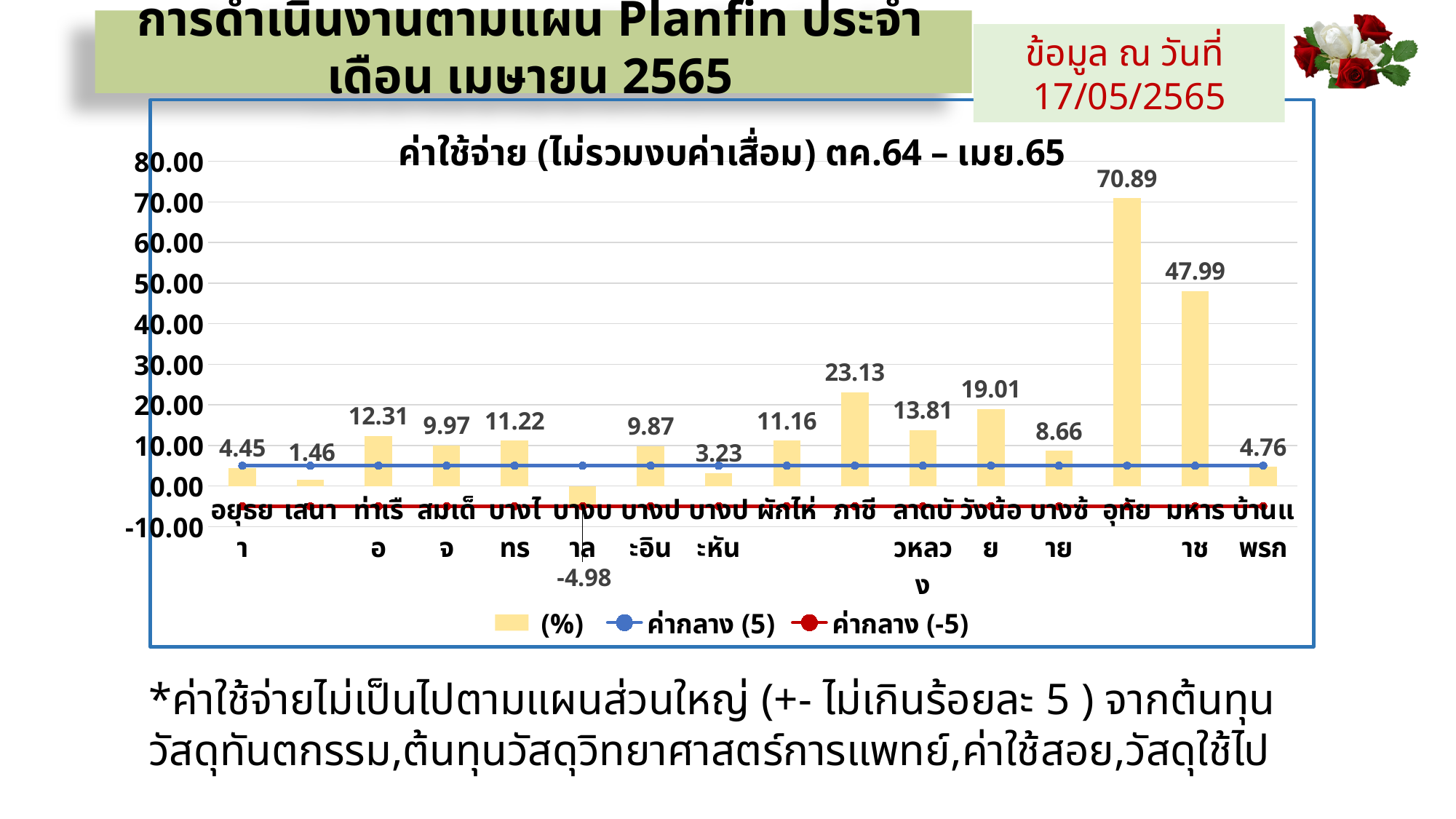
What is the difference between the values for อุทัย and มหาราช? 22.90 How many categories are shown on the x axis? 16 Is the value for มหาราช greater or less than 40.00? greater Which category has the highest value? อุทัย Which category has the lowest value? บางบาล What is the title of the chart? ค่าใช้จ่าย (ไม่รวมงบค่าเสื่อม) ตค.64 – เมย.65 What is the value for บางบาล? -4.98 What is the value for อุทัย? 70.89 What kind of chart is used to show the (%) values? bar chart How many series does the legend list? 3 What is the value for ภาชี? 23.13 Which is larger, the value for วังน้อย or the value for ลาดบัวหลวง? วังน้อย